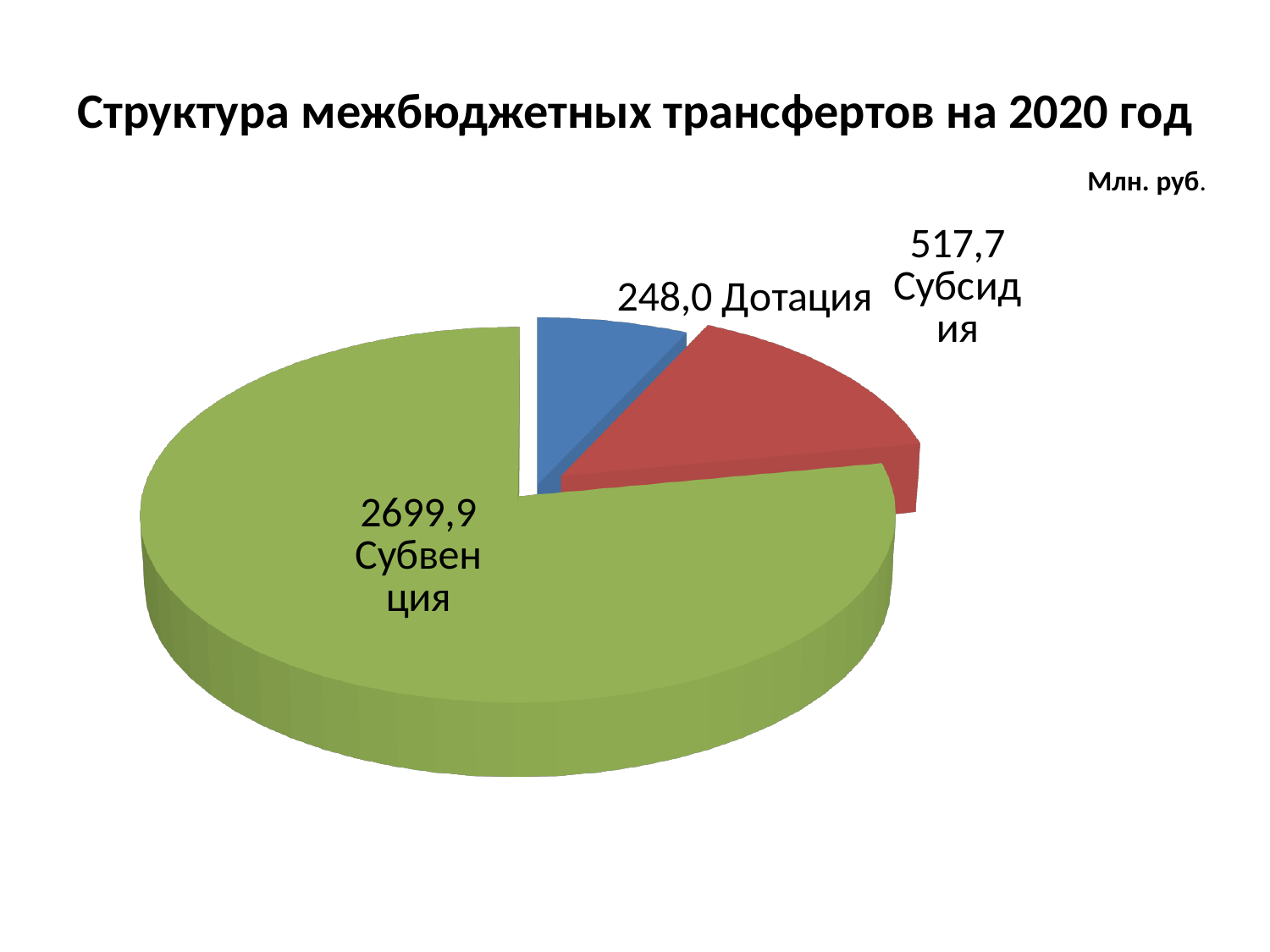
What is the difference between the values for Субсидия and Дотация? 269,7 Which category has the smallest slice of the pie? Дотация What is the value for Дотация? 248,0 What is the difference between the values for Субвенция and Субсидия? 2182,2 Which category has the largest slice of the pie? Субвенция What is the title of the chart? Структура межбюджетных трансфертов на 2020 год What type of chart is shown on the slide? Pie chart What is the value for Субвенция? 2699,9 How many slices does the pie chart have? 3 What is the value for Субсидия? 517,7 In what units are the values on the chart given? Млн. руб. Which is larger, the value for Субсидия or the value for Дотация? Субсидия